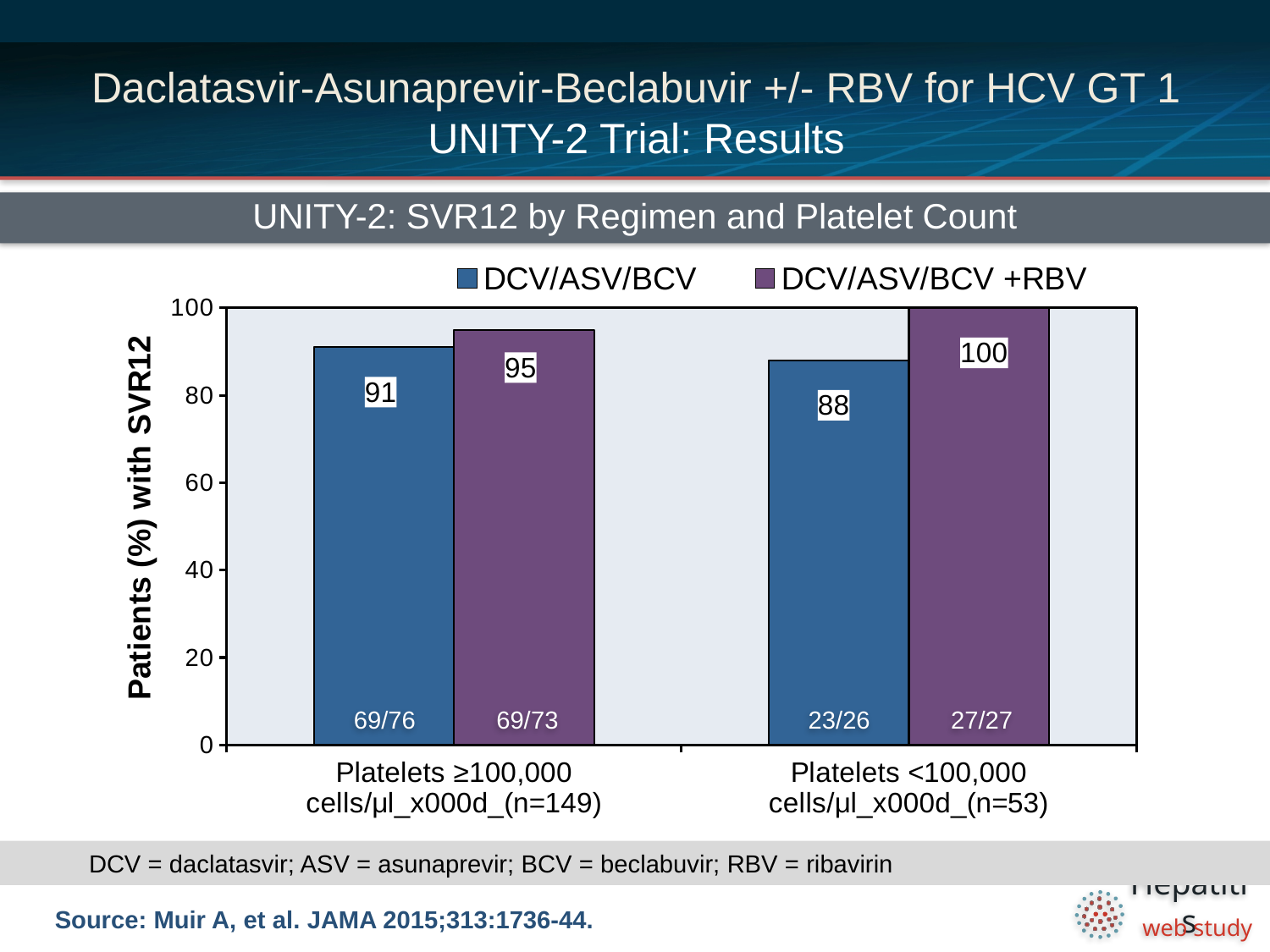
How many platelet count categories are shown on the x axis? 2 What is the SVR12 rate for DCV/ASV/BCV in patients with platelets <100,000 cells/µl? 88 What is the SVR12 rate for DCV/ASV/BCV +RBV in patients with platelets <100,000 cells/µl? 100 In the platelets ≥100,000 cells/µl group, which regimen has the higher SVR12 rate? DCV/ASV/BCV +RBV What is the SVR12 rate for DCV/ASV/BCV +RBV in patients with platelets ≥100,000 cells/µl? 95 What is the label on the y axis of the chart? Patients (%) with SVR12 Which bar shows the lowest SVR12 rate? DCV/ASV/BCV, Platelets <100,000 cells/µl What is the difference in SVR12 rate between DCV/ASV/BCV +RBV and DCV/ASV/BCV in the platelets <100,000 cells/µl group? 12 Which bar shows the highest SVR12 rate? DCV/ASV/BCV +RBV, Platelets <100,000 cells/µl What is the SVR12 rate for DCV/ASV/BCV in patients with platelets ≥100,000 cells/µl? 91 What kind of chart is shown on the slide? Bar chart How many series does the legend list? 2